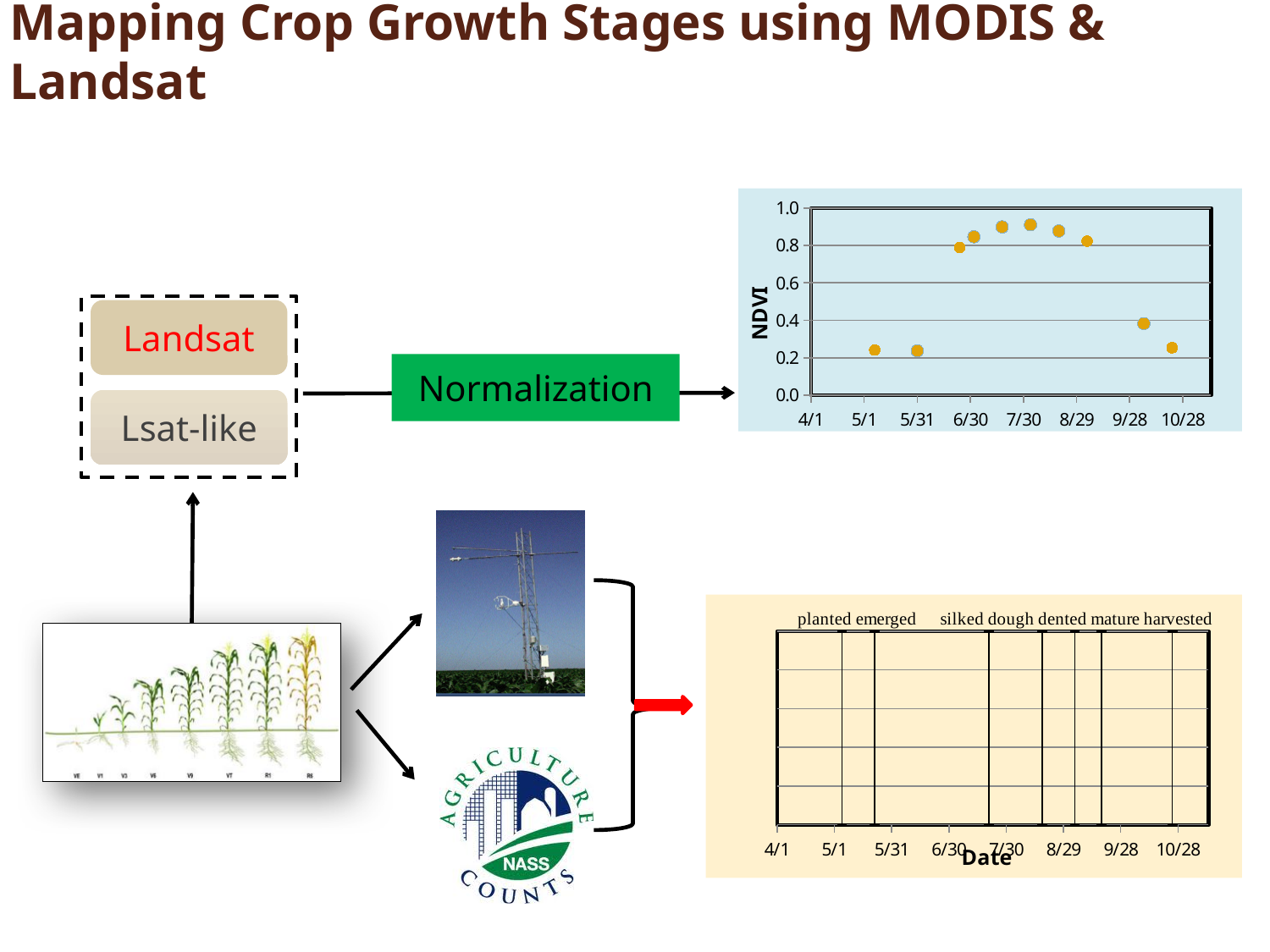
On the NDVI chart, is the value of the point plotted near 7/30 greater or less than 0.8? greater On the NDVI chart, do the values rise or fall between 8/29 and 10/28? fall On the NDVI chart, is the value of the last point, plotted near 10/28, greater or less than 0.4? less What is the highest tick value shown on the vertical axis of the NDVI chart? 1.0 On the NDVI chart, is the value of the point plotted just after 5/1 greater or less than 0.4? less How many data points are plotted on the NDVI chart? 10 What is the first date tick shown on the horizontal axis of the NDVI chart? 4/1 What is the label on the vertical axis of the upper-right chart? NDVI On the NDVI chart, do the values rise or fall between 5/31 and 7/30? rise What kind of chart is the NDVI chart in the upper right of the slide? scatter chart On the NDVI chart, which is larger: the point plotted near 7/30 or the point plotted near 10/28? the point near 7/30